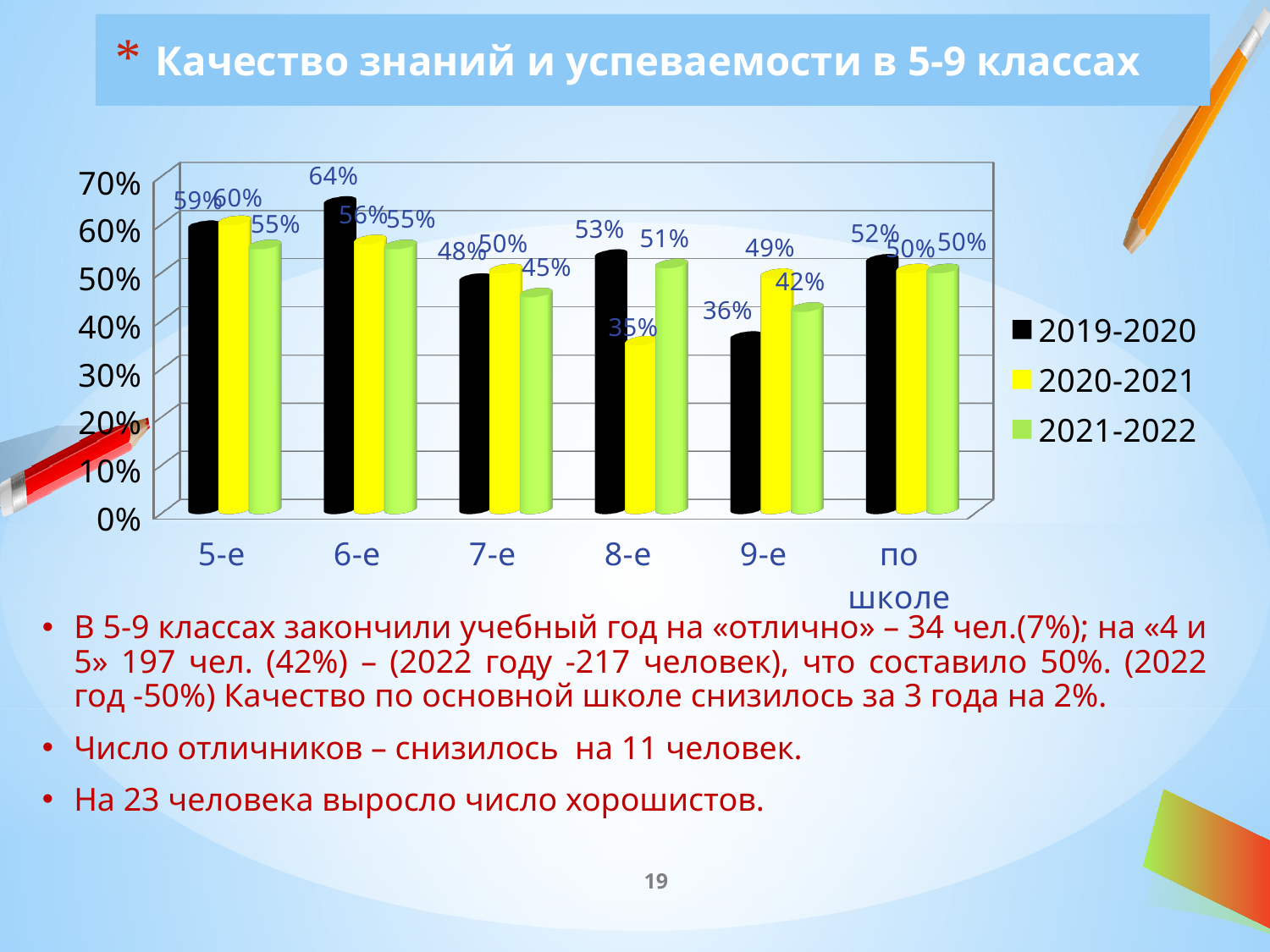
Which is larger for 9-е: the 2019-2020 value or the 2020-2021 value? 2020-2021 Which category has the lowest value in the 2020-2021 series? 8-е How many series does the legend list? 3 What kind of chart is shown on the slide? bar chart What is the value for 9-е in the 2021-2022 series? 42% What is the value for 8-е in the 2020-2021 series? 35% Which colour represents the 2021-2022 series? green How many categories are shown on the x axis? 6 What is the difference between the 2019-2020 and 2020-2021 values for 8-е? 18% What is the value for по школе in the 2019-2020 series? 52% Which category has the highest value in the 2019-2020 series? 6-е What is the value for 6-е in the 2019-2020 series? 64%